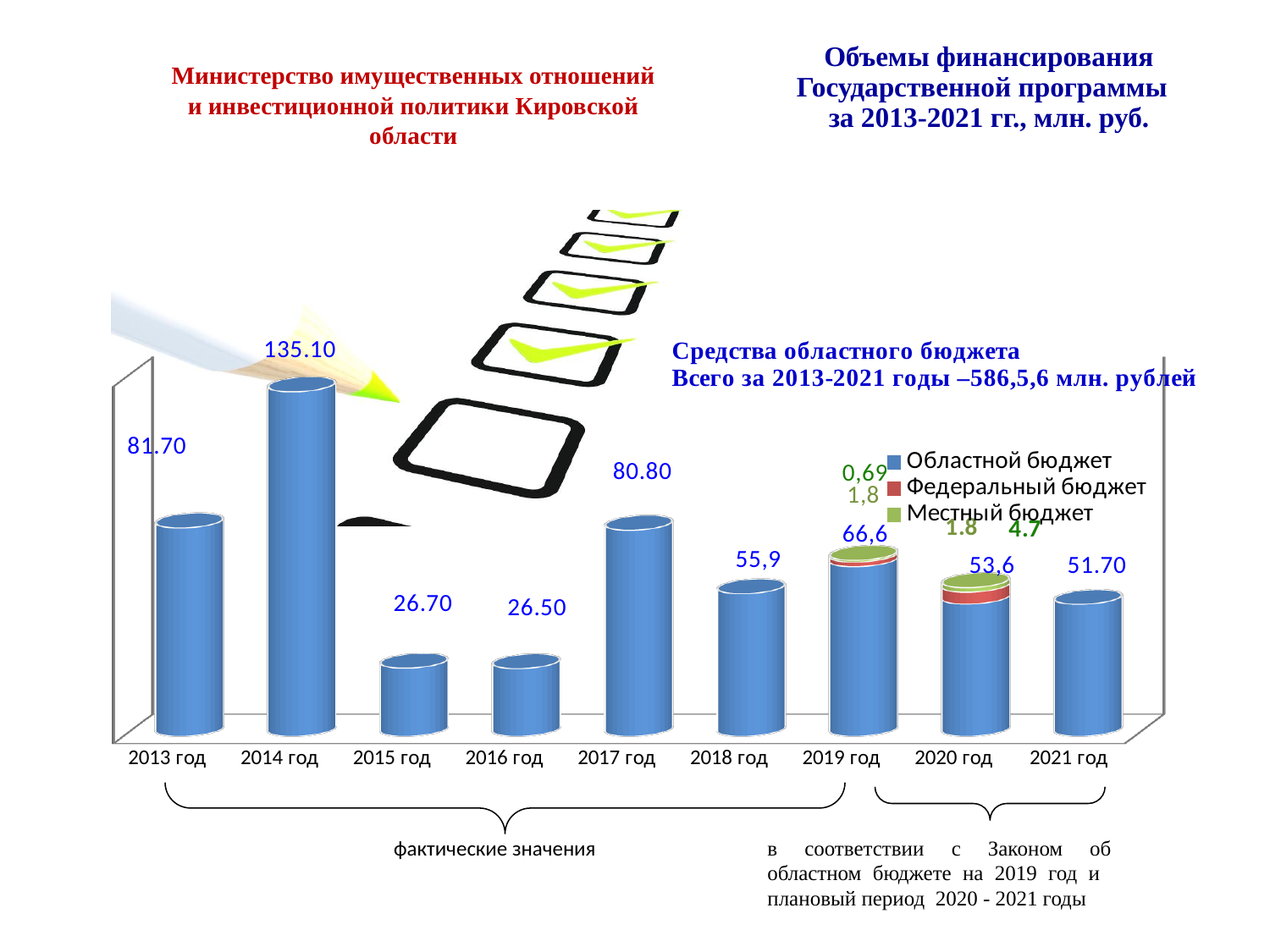
What is the value for 2014 год? 135.10 How many years are shown on the x axis? 9 What is the value for 2013 год? 81.70 What is the difference between the values for 2015 год and 2016 год? 0.20 What is the value for 2018 год? 55,9 How many series does the legend list? 3 Which is larger, the value for 2017 год or 2018 год? 2017 год Which year has the highest value? 2014 год What is the value for 2021 год? 51.70 What kind of chart is shown? bar chart Which year has the lowest value? 2016 год Which colour represents Федеральный бюджет in the legend? red